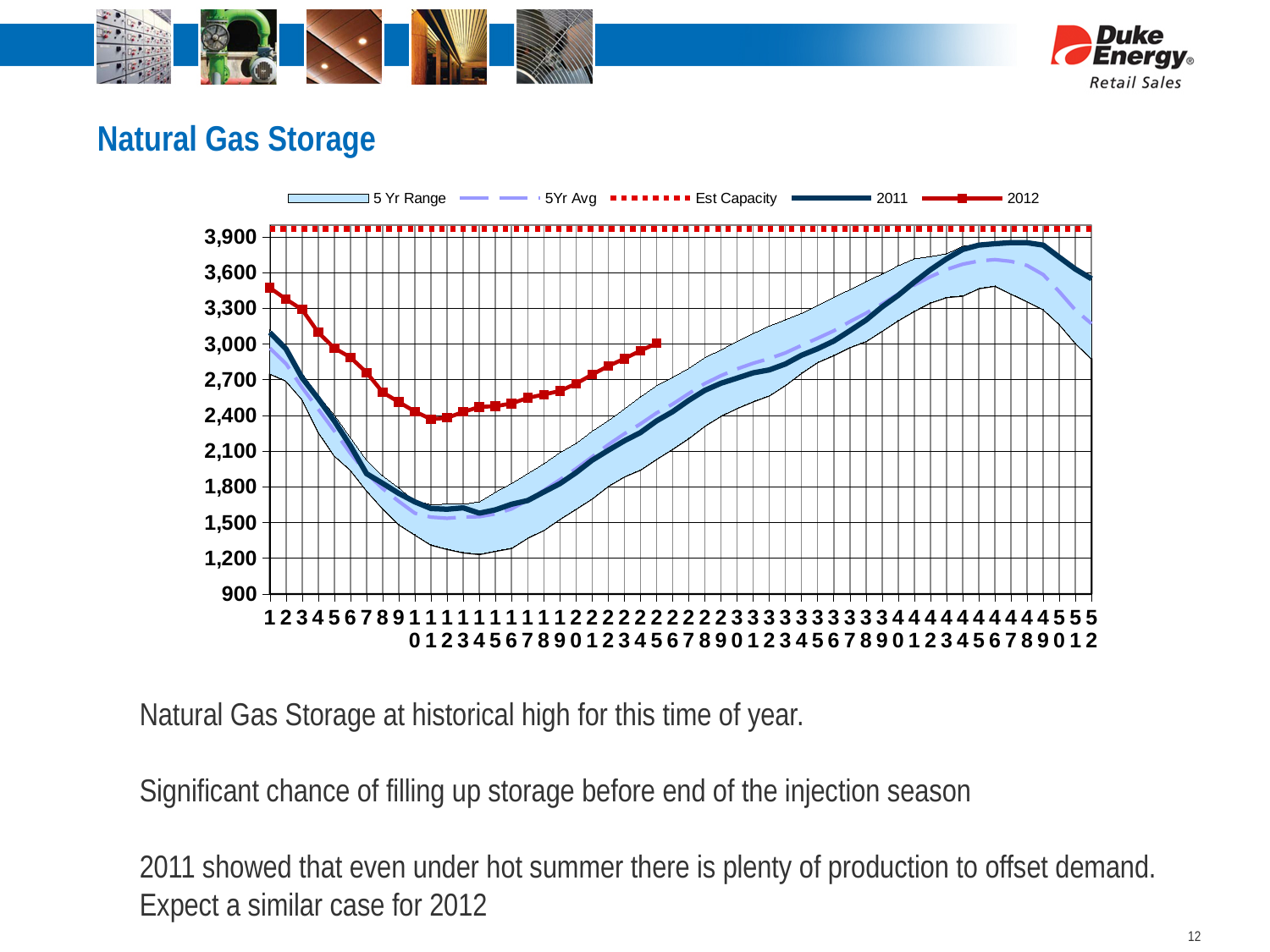
How many points (weeks) are labelled along the x axis? 52 Is the lowest point of the 2011 line greater or less than 1,800? less Does the 2012 line rise or fall from week 1 to week 10? fall What kind of chart is shown on the slide? line chart How many series does the chart legend list? 5 Is the Est Capacity line greater or less than 3,900? greater Is the highest point of the 2011 line greater or less than 3,600? greater What is the title of the chart on the slide? Natural Gas Storage At week 1, which is higher, the 2012 line or the 2011 line? 2012 Which legend entry is drawn as a red dotted line? Est Capacity